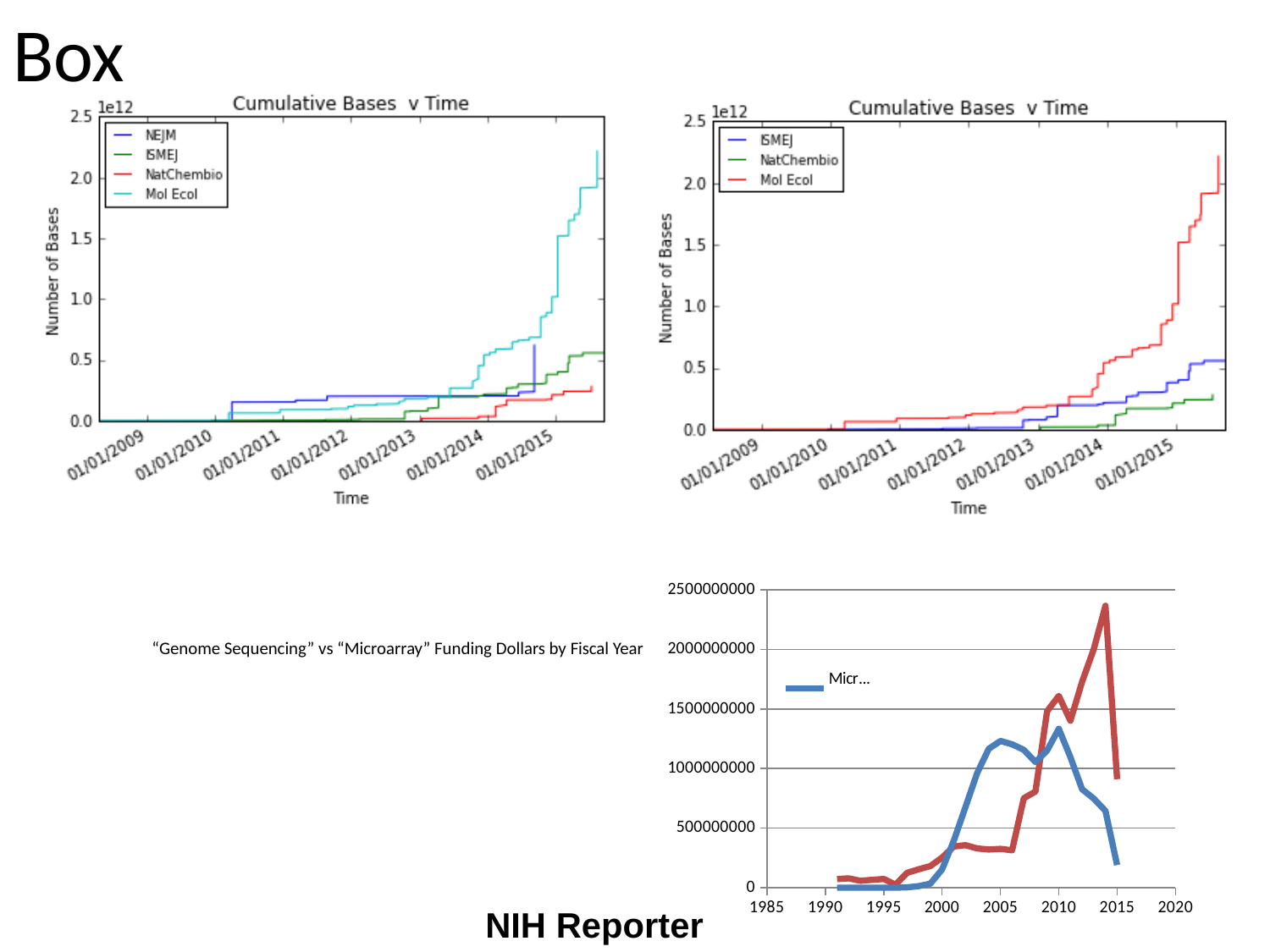
In the top-right 'Cumulative Bases v Time' chart, which series has the lowest value at the right end of the x axis? NatChembio What kind of chart is the bottom-right 'Genome Sequencing vs Microarray Funding Dollars by Fiscal Year' chart? line chart What kind of chart is the top-left 'Cumulative Bases v Time' chart? line chart In the top-left 'Cumulative Bases v Time' chart, is the final value of Mol Ecol greater or less than 2.0 (x1e12)? greater In the bottom-right 'Genome Sequencing vs Microarray Funding Dollars by Fiscal Year' chart, is the value of the blue line at 2015 greater or less than 500000000? less In the top-left 'Cumulative Bases v Time' chart, is the final value of NatChembio greater or less than 0.5 (x1e12)? less In the top-left 'Cumulative Bases v Time' chart, which series reaches the highest value at the right end of the x axis? Mol Ecol How many series does the legend of the top-right 'Cumulative Bases v Time' chart list? 3 How many series does the legend of the top-left 'Cumulative Bases v Time' chart list? 4 What is the y-axis label of the top-left 'Cumulative Bases v Time' chart? Number of Bases In the top-right 'Cumulative Bases v Time' chart, do the values rise or fall over time? rise